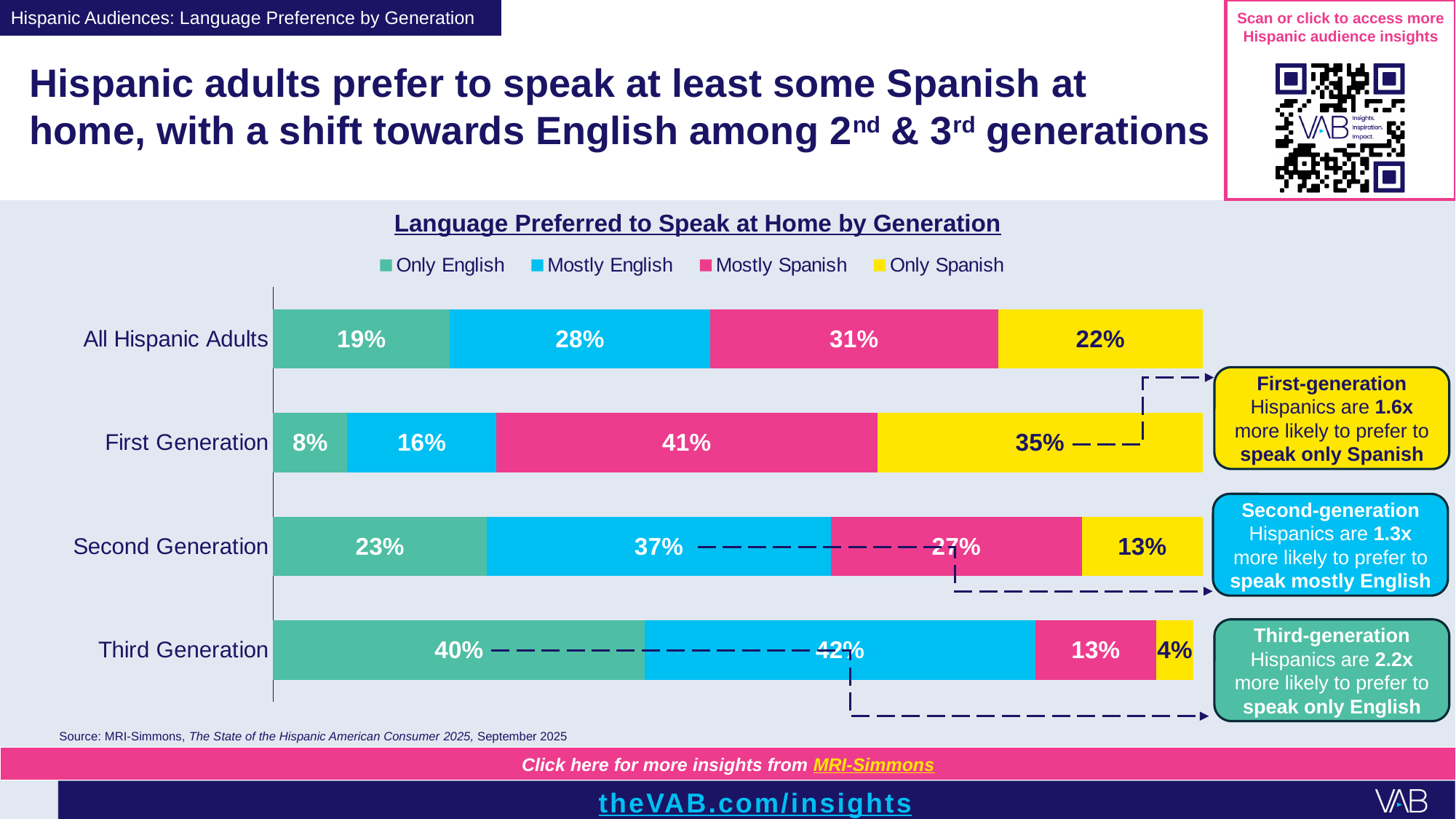
What is the total of the All Hispanic Adults stacked bar? 100% Which category has the lowest Only English value? First Generation How many series does the legend list? 4 Does the Only English value rise or fall going from First Generation to Third Generation? Rises Which generation has the highest Only Spanish value? First Generation What kind of chart is shown on the slide? Stacked bar chart How many categories (bars) are shown in the chart? 4 What is the Only English value for Third Generation? 40% What share of All Hispanic Adults prefer Mostly Spanish at home? 31% What percentage of First Generation Hispanics prefer to speak Only Spanish at home? 35% Which has a larger Mostly English value: Second Generation or All Hispanic Adults? Second Generation How many percentage points higher is the Only Spanish value for First Generation than for Third Generation? 31 percentage points